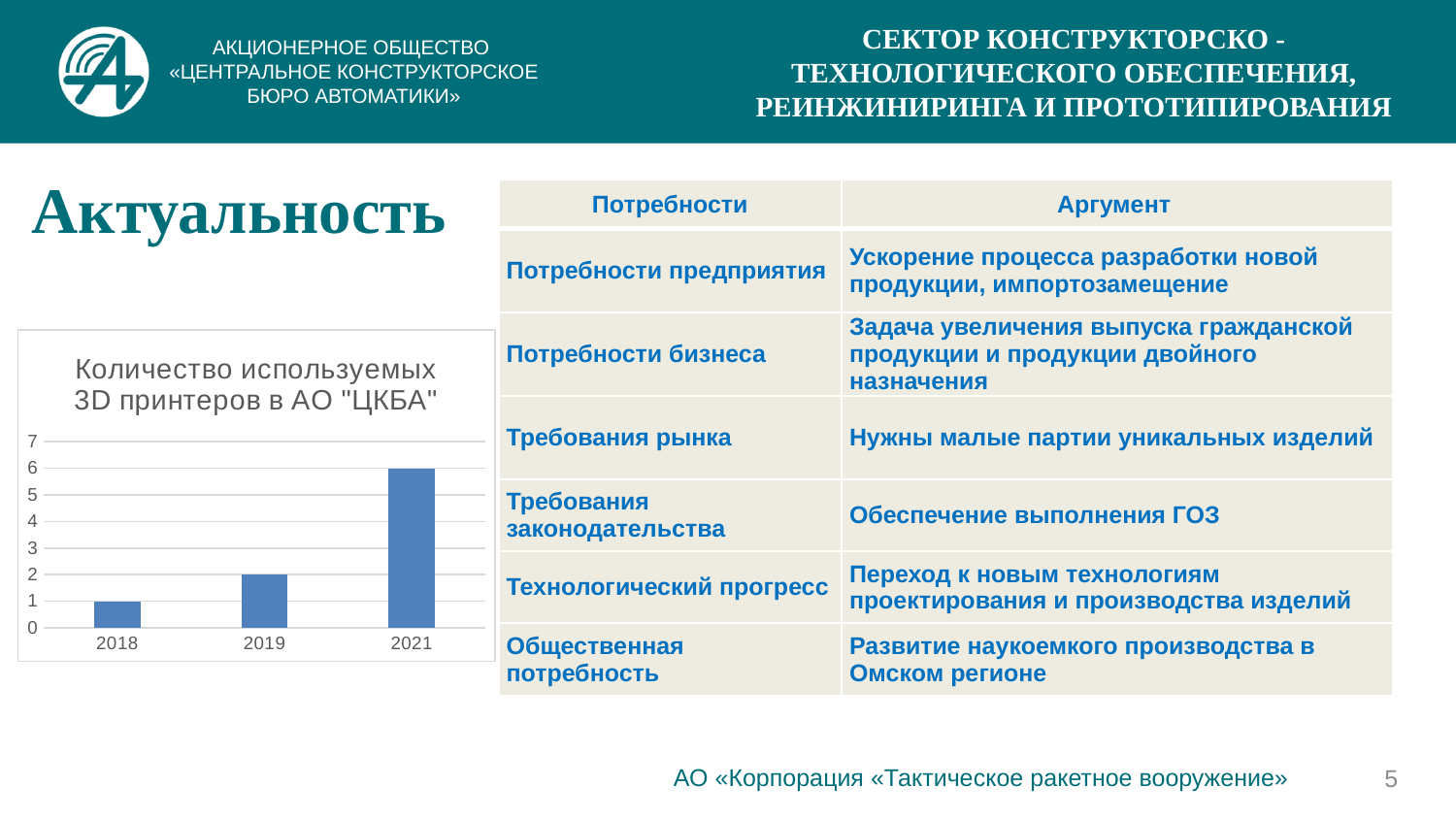
What is the difference between the values for 2021 and 2019? 4 Which year has the lowest value in the chart? 2018 Which is larger, the value for 2019 or the value for 2021? 2021 How many categories (years) are shown on the x axis of the chart? 3 What is the title of the chart? Количество используемых 3D принтеров в АО "ЦКБА" What kind of chart is shown on the slide? bar chart What is the value for 2018 in the chart? 1 What is the value for 2021 in the chart? 6 What is the value for 2019 in the chart? 2 Do the values rise or fall from 2018 to 2021 along the x axis? rise Is the value for 2021 greater or less than 5? greater Which year has the highest value in the chart? 2021